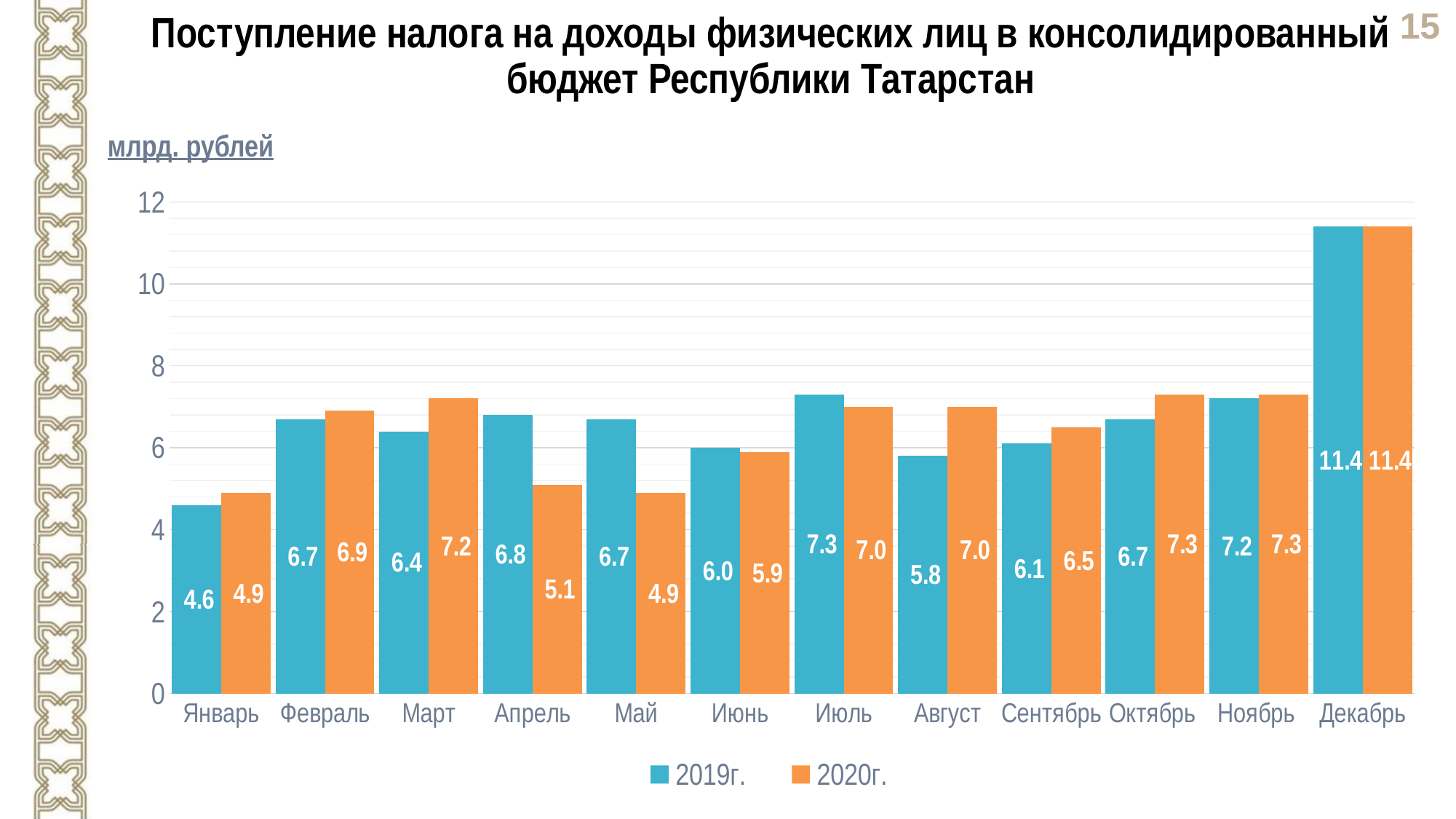
Which month has the lowest value for 2020г.? Январь and Май (both 4.9) In Май, which series has the larger value, 2019г. or 2020г.? 2019г. What is the value for 2020г. in Сентябрь? 6.5 Is the value for 2019г. in Июль greater or less than 6? greater What unit is stated above the chart? млрд. рублей What kind of chart is shown on the slide? bar chart How many series does the legend list? 2 What is the value for 2020г. in Апрель? 5.1 How many months are shown on the x axis? 12 Which month has the highest value for 2019г.? Декабрь What is the difference between the 2020г. and 2019г. values in Август? 1.2 What is the value for 2019г. in Март? 6.4